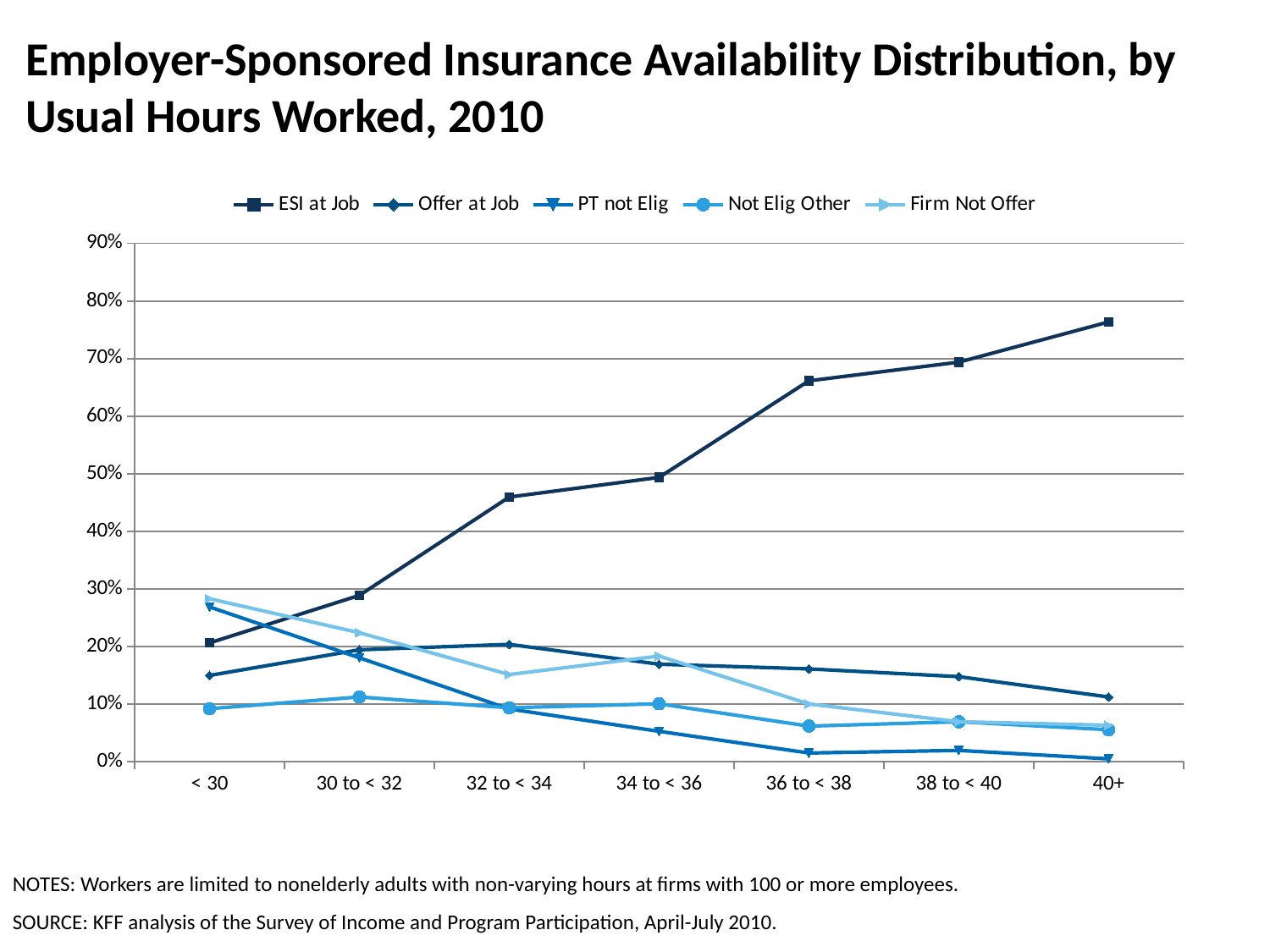
Is the value for ESI at Job in the < 30 category greater or less than 30%? less Is the value for Firm Not Offer in the < 30 category greater or less than 20%? greater Is the value for ESI at Job in the 40+ category greater or less than 70%? greater Does the ESI at Job line rise or fall as usual hours worked increase along the x axis? rise What kind of chart is shown on the slide? line chart How many usual-hours categories are shown on the x axis? 7 Does the PT not Elig line rise or fall as usual hours worked increase along the x axis? fall In the 36 to < 38 category, which is larger: ESI at Job or Offer at Job? ESI at Job Which series has the lowest value in the 40+ category? PT not Elig What is the title of the chart? Employer-Sponsored Insurance Availability Distribution, by Usual Hours Worked, 2010 How many series does the legend list? 5 Which usual-hours category has the highest value for ESI at Job? 40+